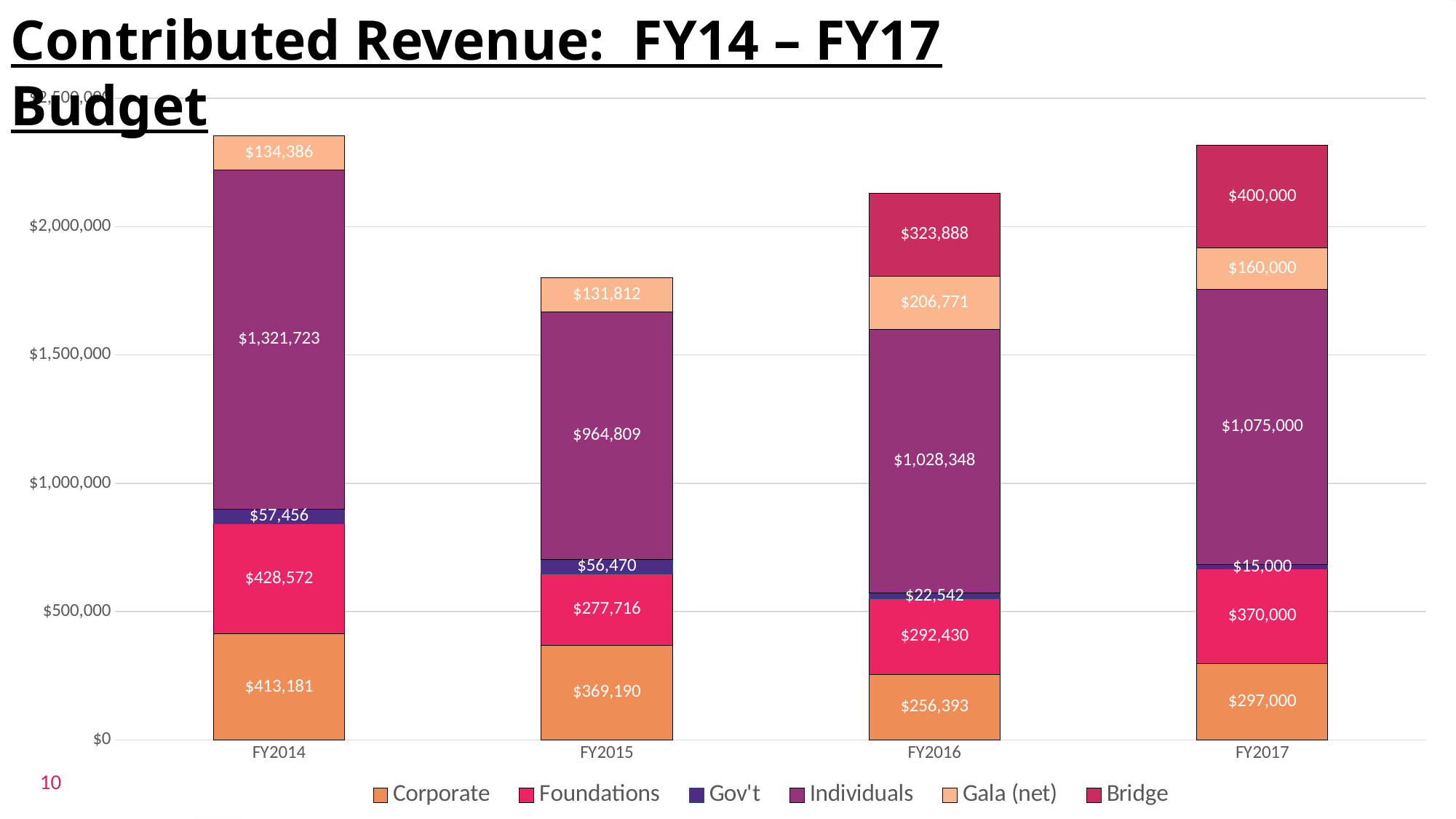
How many fiscal years are shown on the x axis? 4 What is the Bridge value for FY2016? $323,888 Which is larger, the Gala (net) value for FY2016 or for FY2017? FY2016 What is the total of the stacked bar for FY2017? $2,317,000 What is the Corporate value for FY2015? $369,190 In which fiscal year is the Gov't value lowest? FY2017 What kind of chart is shown on the slide? Stacked bar chart What is the difference between the Foundations values for FY2014 and FY2015? $150,856 In which fiscal year is the Individuals value highest? FY2014 What is the Individuals value for FY2014? $1,321,723 How many series does the legend list? 6 What is the Gov't value for FY2017? $15,000